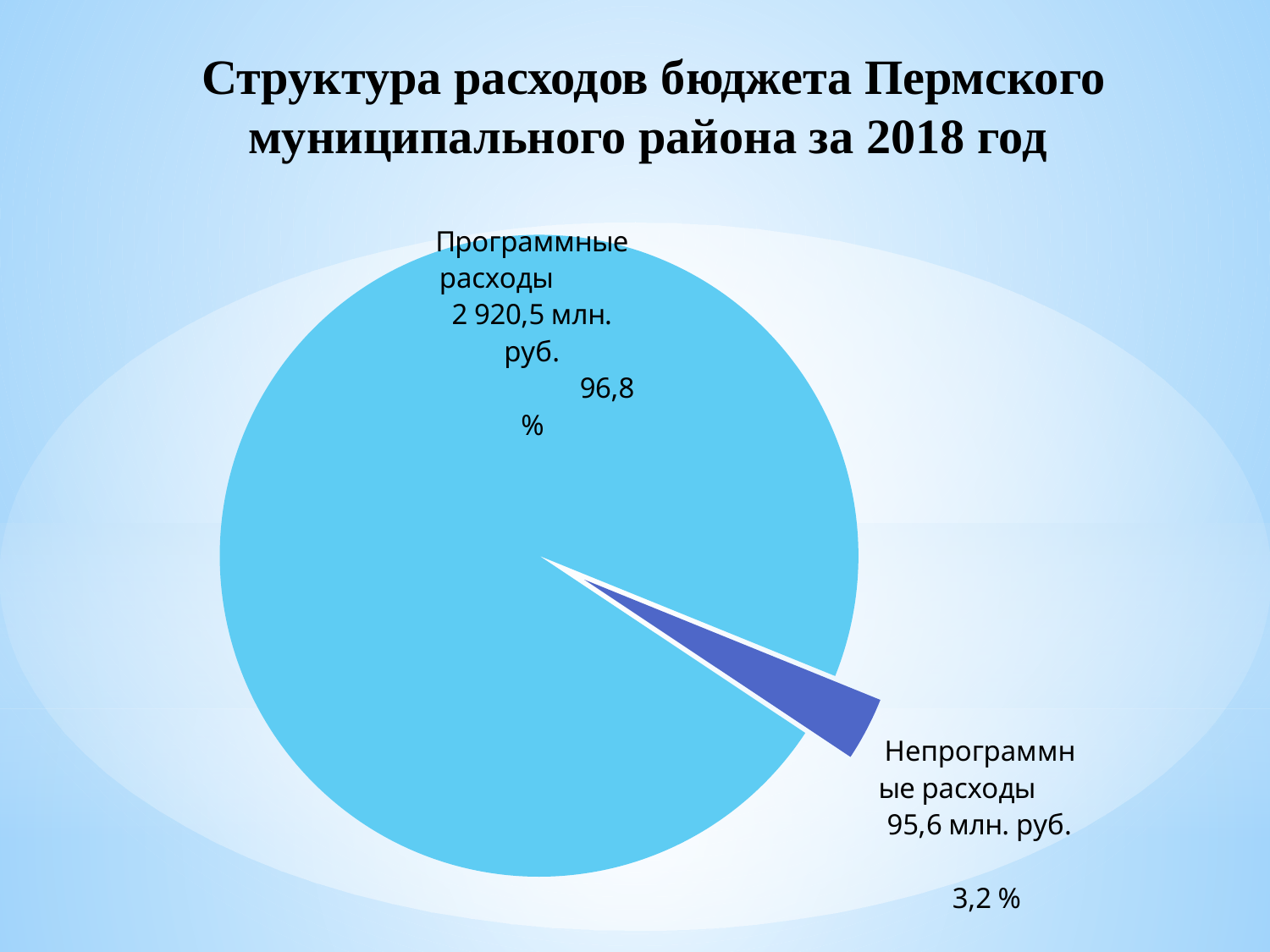
What colour is the slice for Непрограммные расходы? dark blue What share of the pie is Непрограммные расходы? 3,2 % How many slices does the pie chart have? 2 What is the difference in percentage share between Программные расходы and Непрограммные расходы? 93,6 % Which slice is the smallest? Непрограммные расходы What kind of chart is shown on the slide? pie chart Which slice is the largest? Программные расходы What is the value for Программные расходы? 2 920,5 млн. руб. What is the title of the chart? Структура расходов бюджета Пермского муниципального района за 2018 год What share of the pie is Программные расходы? 96,8 % Which is larger, Программные расходы or Непрограммные расходы? Программные расходы What is the value for Непрограммные расходы? 95,6 млн. руб.